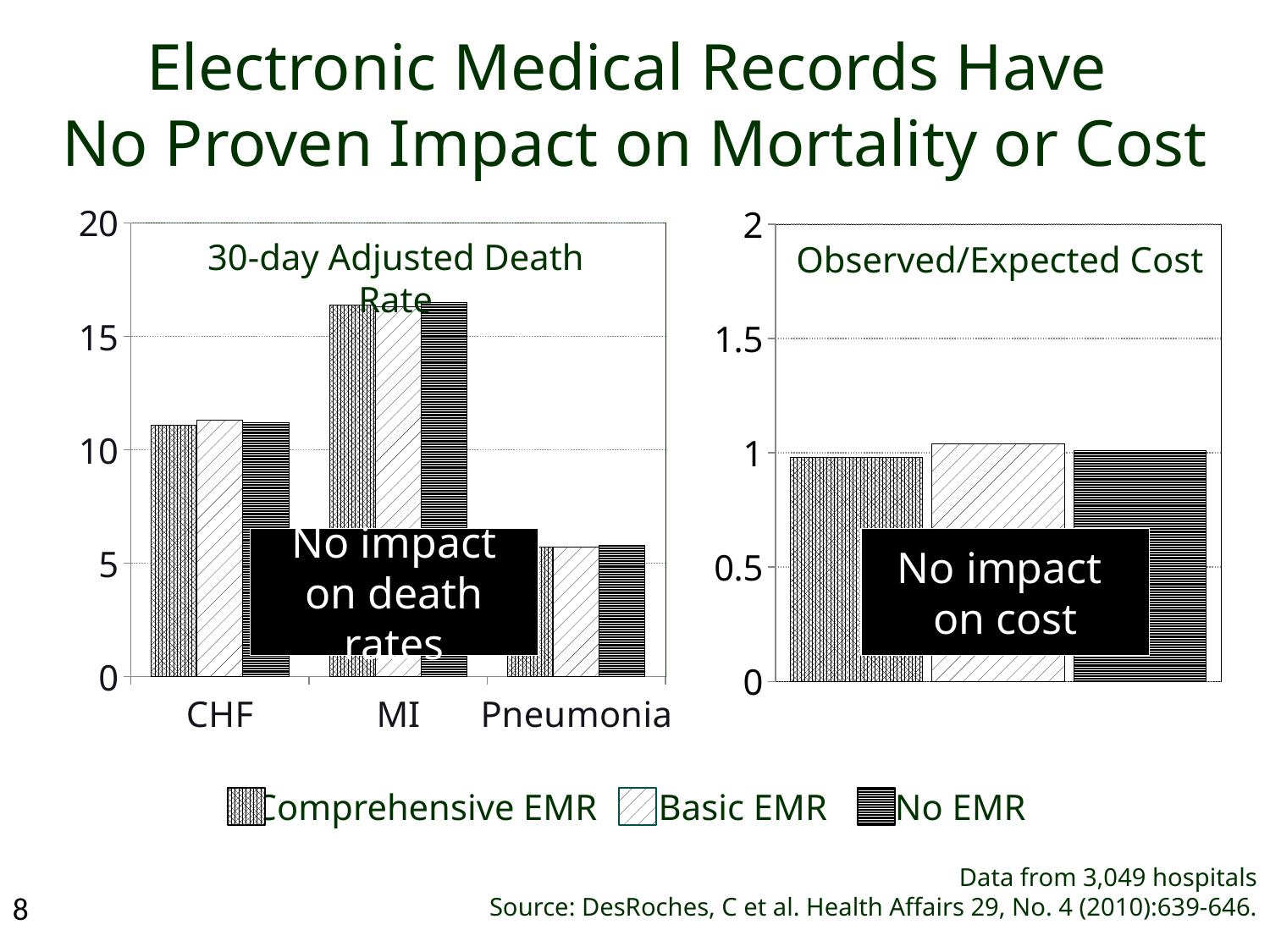
What kind of chart is the 30-day Adjusted Death Rate chart? bar chart How many categories are shown on the x axis of the 30-day Adjusted Death Rate chart? 3 In the 30-day Adjusted Death Rate chart, is the Comprehensive EMR value for Pneumonia greater or less than 10? less In the 30-day Adjusted Death Rate chart, is the No EMR value for MI greater or less than 15? greater In the 30-day Adjusted Death Rate chart, which category has the lowest death rate? Pneumonia In the 30-day Adjusted Death Rate chart, which category has the highest death rate? MI How many series does the legend list for the charts on this slide? 3 In the Observed/Expected Cost chart, is the Basic EMR value greater or less than 1.5? less In the 30-day Adjusted Death Rate chart, which is larger: the Comprehensive EMR value for MI or the Comprehensive EMR value for CHF? MI What are the three series named in the legend? Comprehensive EMR, Basic EMR, No EMR